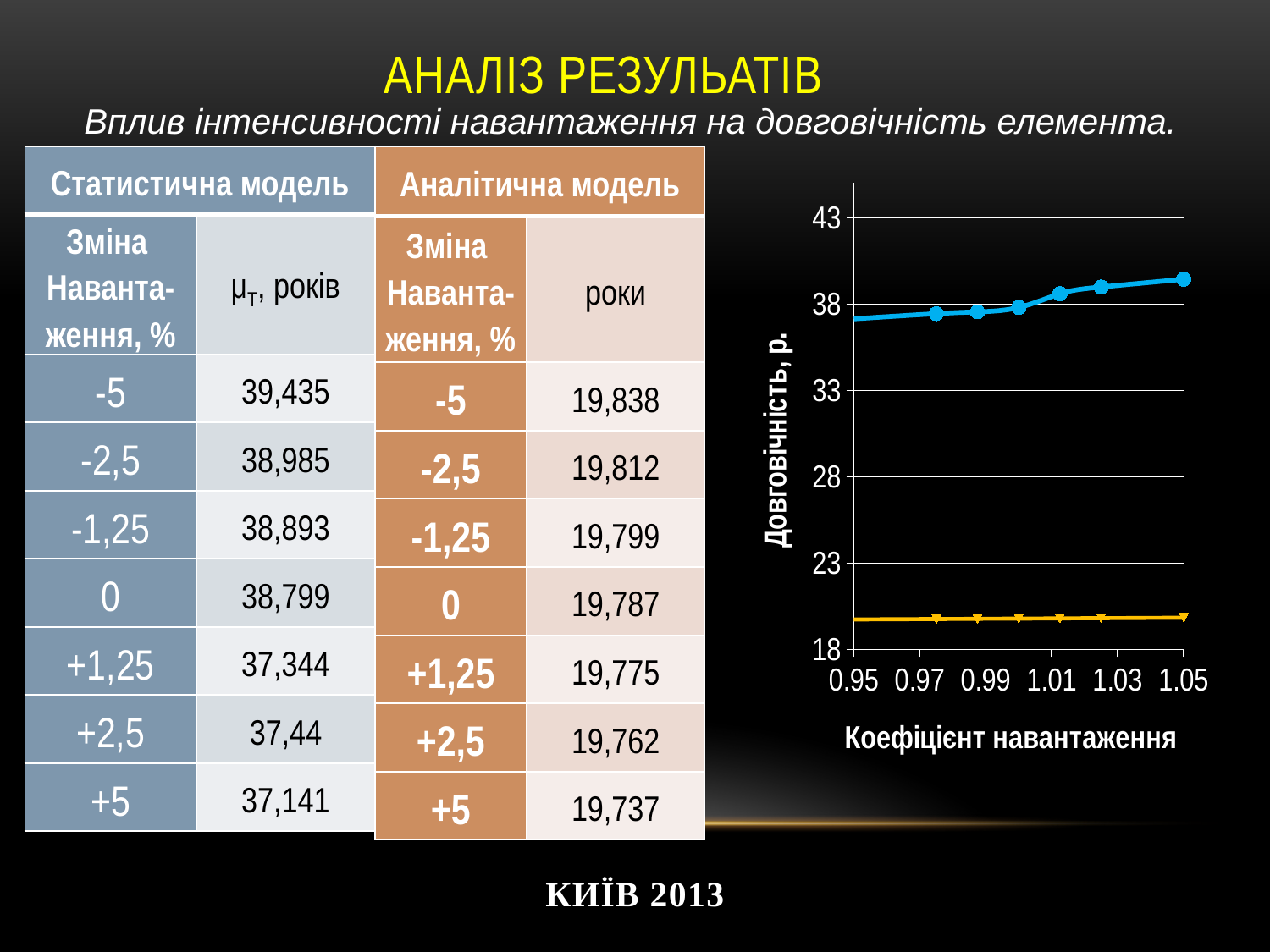
What is the title of the horizontal axis of the chart? Коефіцієнт навантаження At a load coefficient of 1.05, which line has the higher value, the blue or the yellow? blue How many lines are plotted on the chart? 2 How many data points does the blue line have? 7 Does the blue line rise or fall as the load coefficient increases from 0.95 to 1.05? rises What kind of chart is shown on the right of the slide? line chart Is the value of the blue line at a load coefficient of 0.95 greater or less than 33? greater At which load coefficient does the blue line reach its highest value? 1.05 At which load coefficient does the blue line have its lowest value? 0.95 Is the value of the blue line at a load coefficient of 1.05 greater or less than 38? greater What is the title of the vertical axis of the chart? Довговічність, р. Is the value of the yellow line at a load coefficient of 1.05 greater or less than 23? less